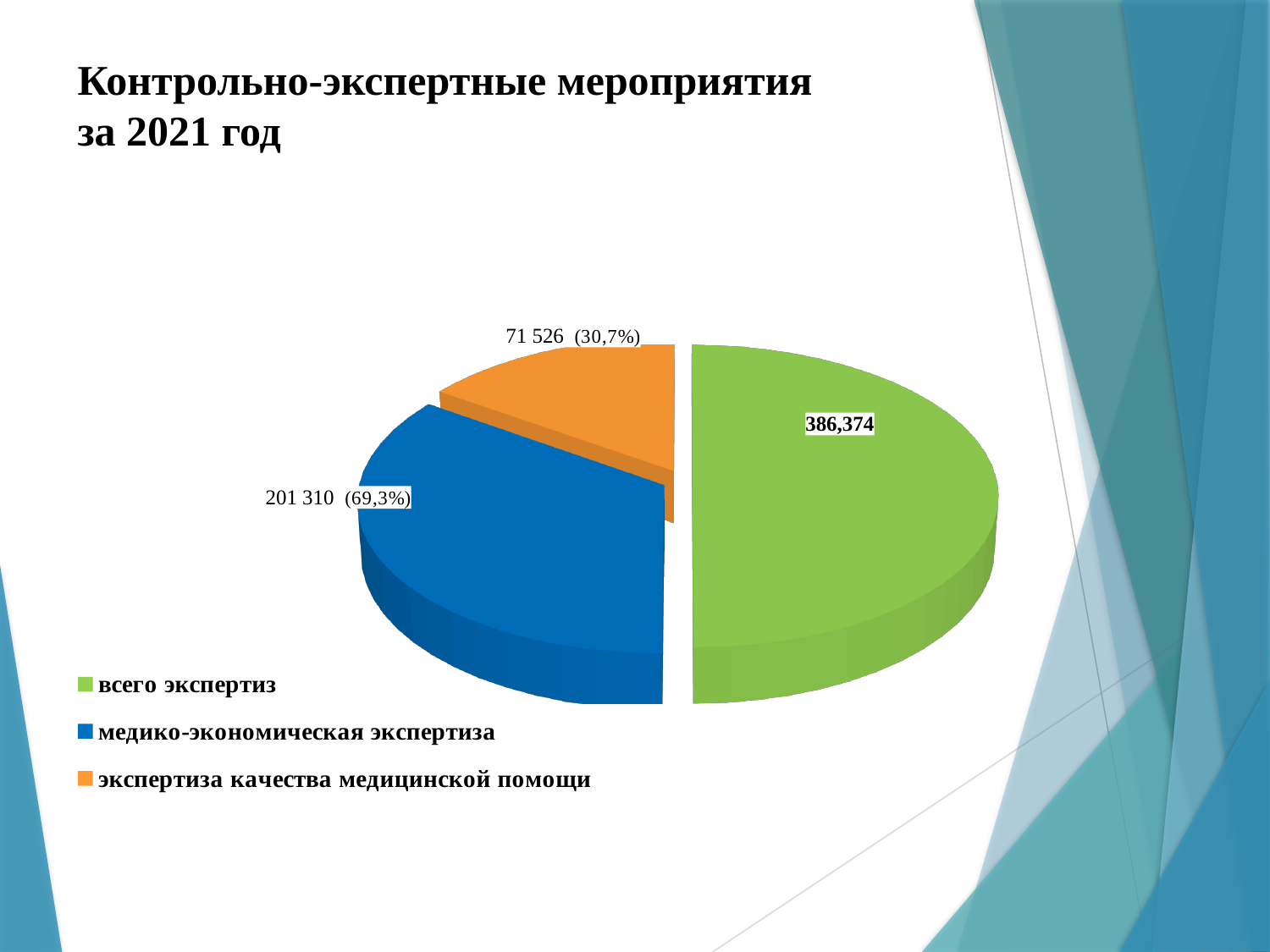
What percentage is printed next to the "медико-экономическая экспертиза" slice? 69,3% What value is shown for "экспертиза качества медицинской помощи"? 71 526 What value is shown for "медико-экономическая экспертиза"? 201 310 What is the difference between the values for "медико-экономическая экспертиза" and "экспертиза качества медицинской помощи"? 129 784 Which category has the smallest slice in the pie chart? экспертиза качества медицинской помощи Which is larger: "медико-экономическая экспертиза" or "экспертиза качества медицинской помощи"? медико-экономическая экспертиза What value is shown for "всего экспертиз"? 386,374 What percentage is printed next to the "экспертиза качества медицинской помощи" slice? 30,7% What is the title of the slide containing the pie chart? Контрольно-экспертные мероприятия за 2021 год Which category has the largest slice in the pie chart? всего экспертиз How many slices does the pie chart have? 3 What kind of chart is shown on the slide? pie chart